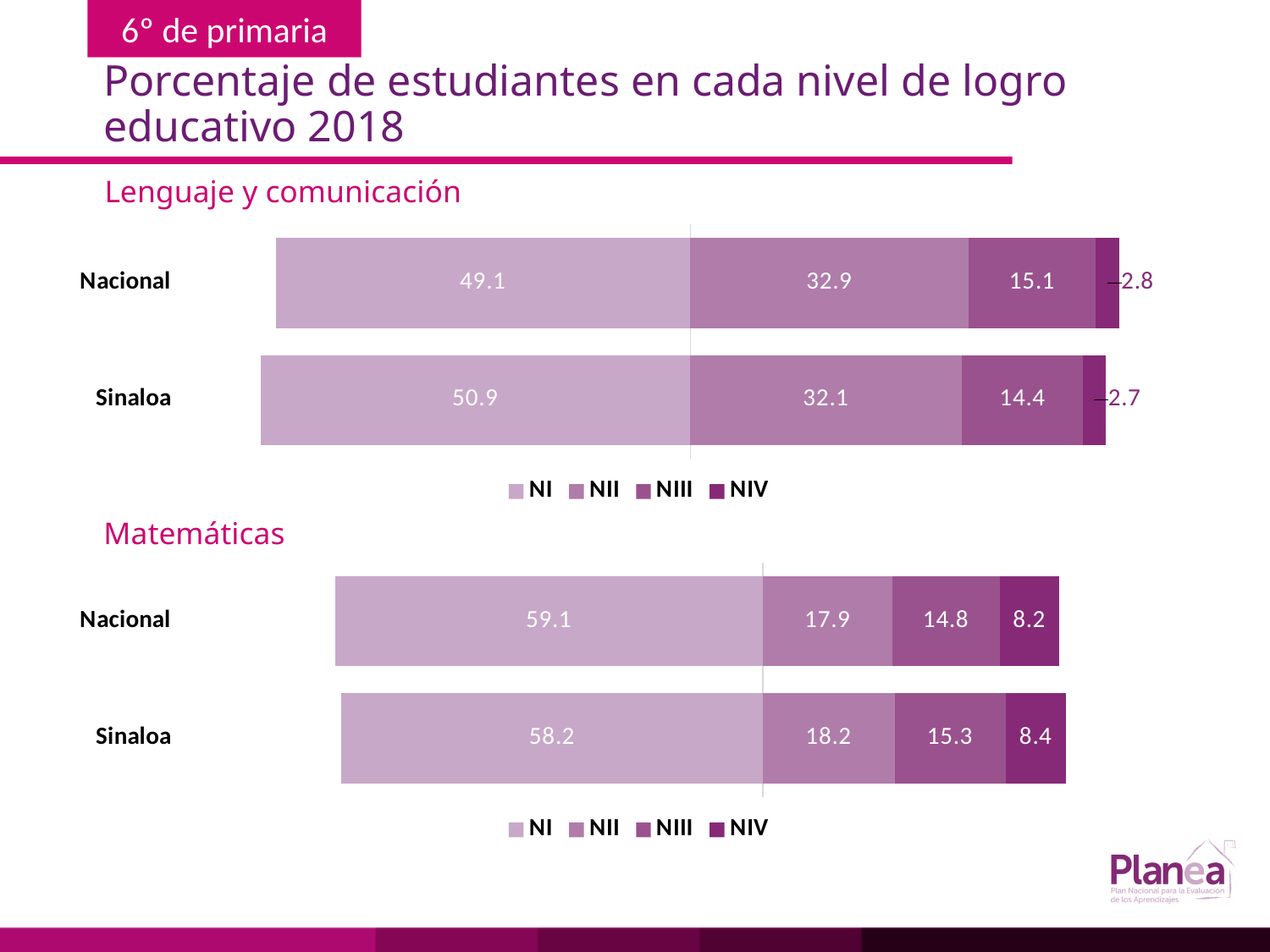
How many series does the legend of the Lenguaje y comunicación chart list? 4 In the Lenguaje y comunicación chart, what is the NIV value for Nacional? 2.8 In the Matemáticas chart, which is larger, the NIV value for Nacional or for Sinaloa? Sinaloa In the Matemáticas chart, what is the NII value for Sinaloa? 18.2 In the Lenguaje y comunicación chart, which level has the lowest value for Sinaloa? NIV In the Matemáticas chart, which level has the highest value for Nacional? NI In the Lenguaje y comunicación chart, what is the difference between the NI values for Sinaloa and Nacional? 1.8 In the Lenguaje y comunicación chart, what is the NI value for Sinaloa? 50.9 In the Matemáticas chart, what is the total of the stacked bar for Nacional? 100.0 What kind of chart is the Lenguaje y comunicación chart? Stacked bar chart In the Matemáticas chart, what is the NIII value for Nacional? 14.8 How many categories are shown in the Matemáticas chart? 2